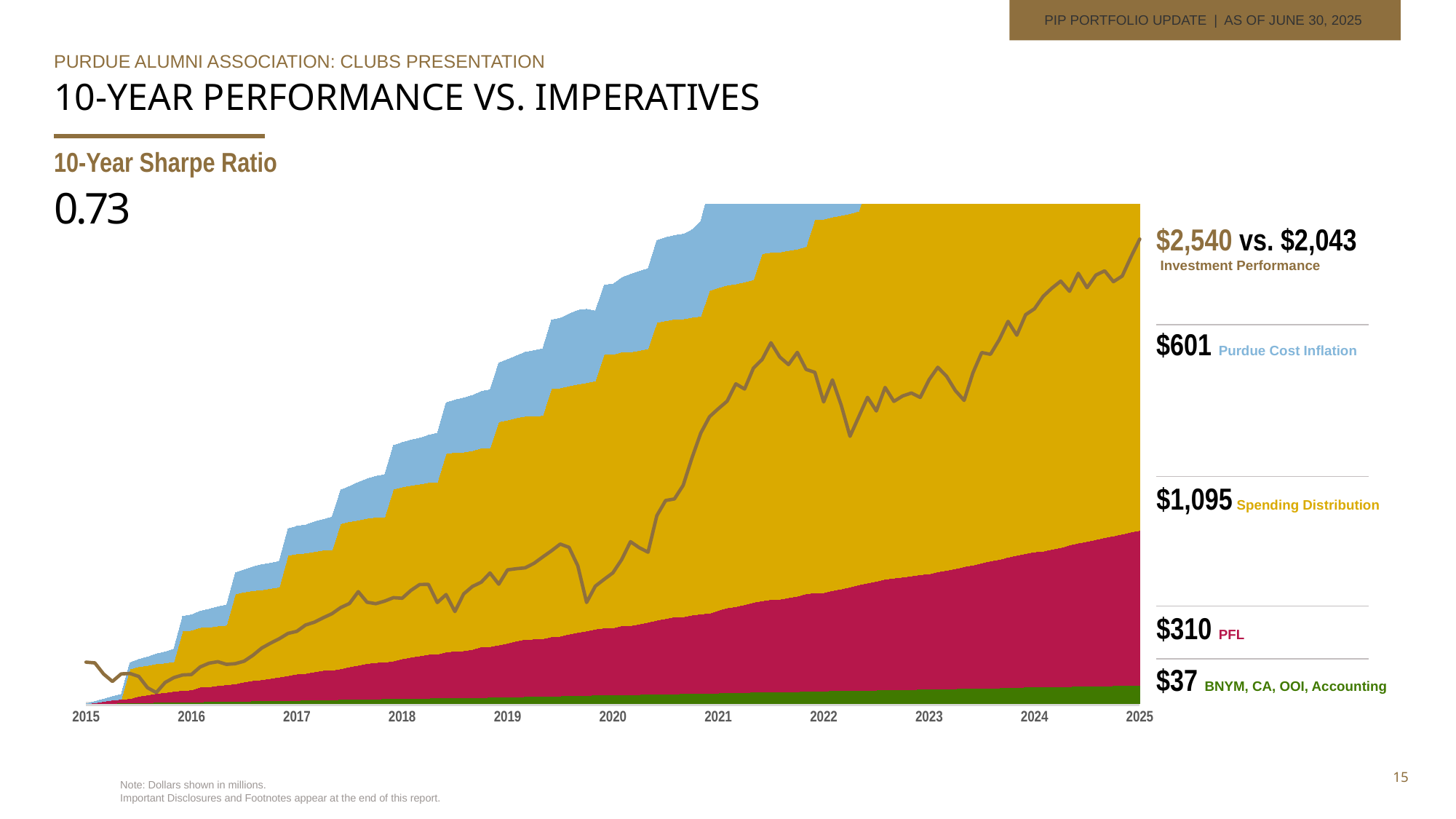
What is the value shown for Purdue Cost Inflation? $601 What is the 10-Year Sharpe Ratio shown on the slide? 0.73 What is the value shown for Spending Distribution? $1,095 What two values are shown for Investment Performance? $2,540 vs. $2,043 Which of the stacked components has the smallest value? BNYM, CA, OOI, Accounting What is the difference between the Spending Distribution value and the PFL value? $785 What is the value shown for PFL? $310 What is the total of the four stacked components ($601, $1,095, $310 and $37)? $2,043 What is the value shown for BNYM, CA, OOI, Accounting? $37 Which is larger, the value for PFL or the value for Purdue Cost Inflation? Purdue Cost Inflation What is the difference between the two Investment Performance values, $2,540 and $2,043? $497 Which of the stacked components (Purdue Cost Inflation, Spending Distribution, PFL, BNYM/CA/OOI/Accounting) has the largest value? Spending Distribution